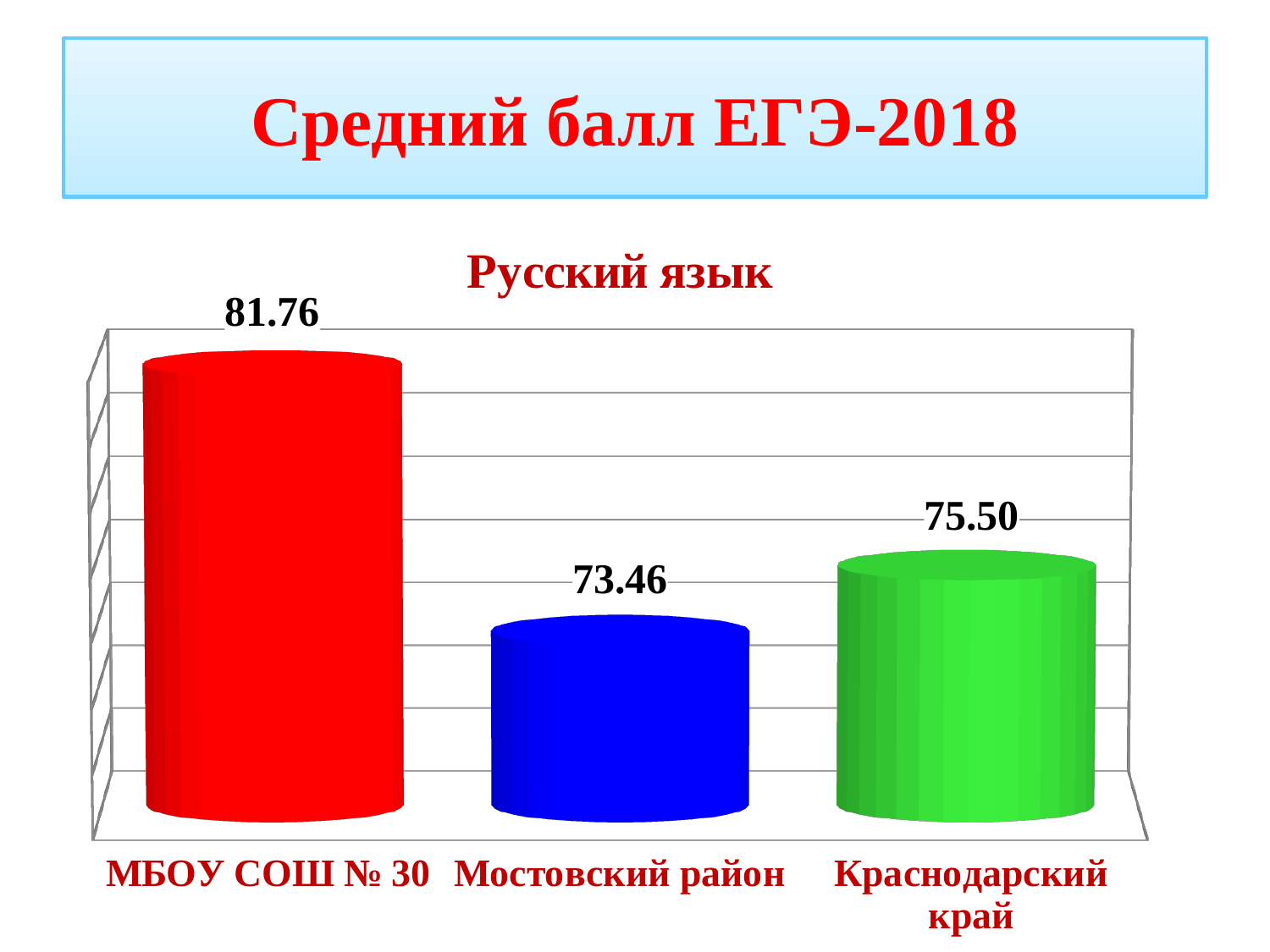
What is the value for МБОУ СОШ № 30? 81.76 What is the value for Краснодарский край? 75.50 What is the difference between the values for Краснодарский край and Мостовский район? 2.04 What is the difference between the values for МБОУ СОШ № 30 and Мостовский район? 8.30 What is the title of the chart? Русский язык Which is larger, the value for Краснодарский край or the value for Мостовский район? Краснодарский край What is the value for Мостовский район? 73.46 How many categories are shown in the chart? 3 What kind of chart is shown on the slide? Bar chart Which category has the highest value? МБОУ СОШ № 30 Which category has the lowest value? Мостовский район What is the difference between the values for МБОУ СОШ № 30 and Краснодарский край? 6.26